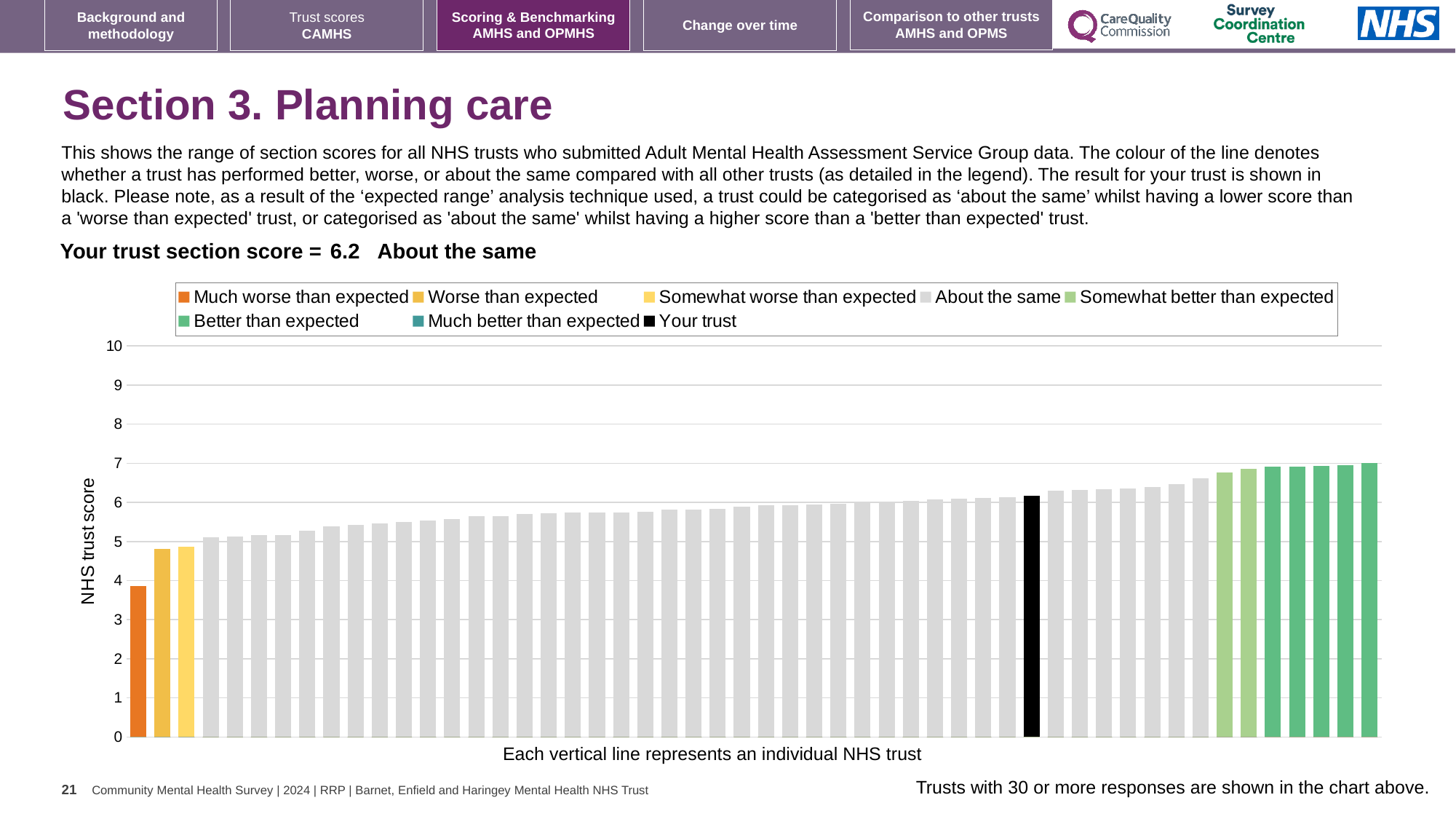
How many entries does the chart legend list? 8 What kind of chart is shown on the slide? bar chart What is the label on the vertical axis of the chart? NHS trust score Is the value for your trust (the black bar) greater or less than 6? greater Do the bar values rise or fall from left to right along the x axis? rise Is the value for the lowest bar (the orange 'Much worse than expected' trust) greater or less than 4? less How many bars are coloured dark green ('Better than expected')? 5 What is your trust's section score for Planning care? 6.2 Which category is your trust placed in for this section? About the same How many bars are coloured orange ('Much worse than expected')? 1 Which legend category does the lowest bar in the chart belong to? Much worse than expected Is the value for the tallest bar in the chart greater or less than 6? greater